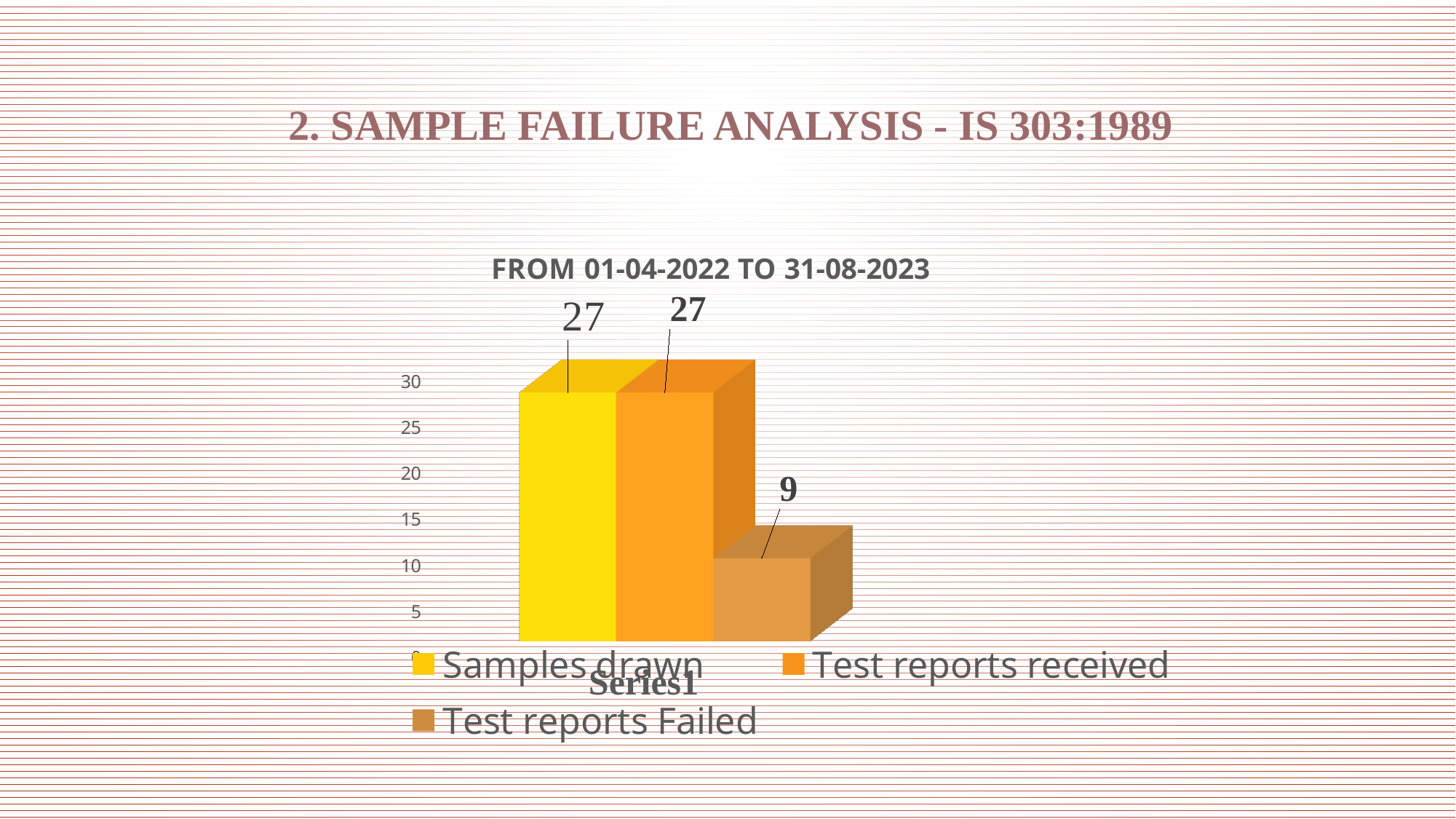
What is the title of the chart? FROM 01-04-2022 TO 31-08-2023 Which series has the lowest value? Test reports Failed What is the value for Test reports Failed? 9 Which is larger, Samples drawn or Test reports Failed? Samples drawn What kind of chart is shown on the slide? bar chart Is the value for Test reports Failed greater or less than 10? less What is the value for Test reports received? 27 What is the difference between Test reports received and Test reports Failed? 18 What is the category label shown on the x axis? Series1 How many series does the legend list? 3 What is the value for Samples drawn? 27 Is the value for Samples drawn greater or less than 25? greater